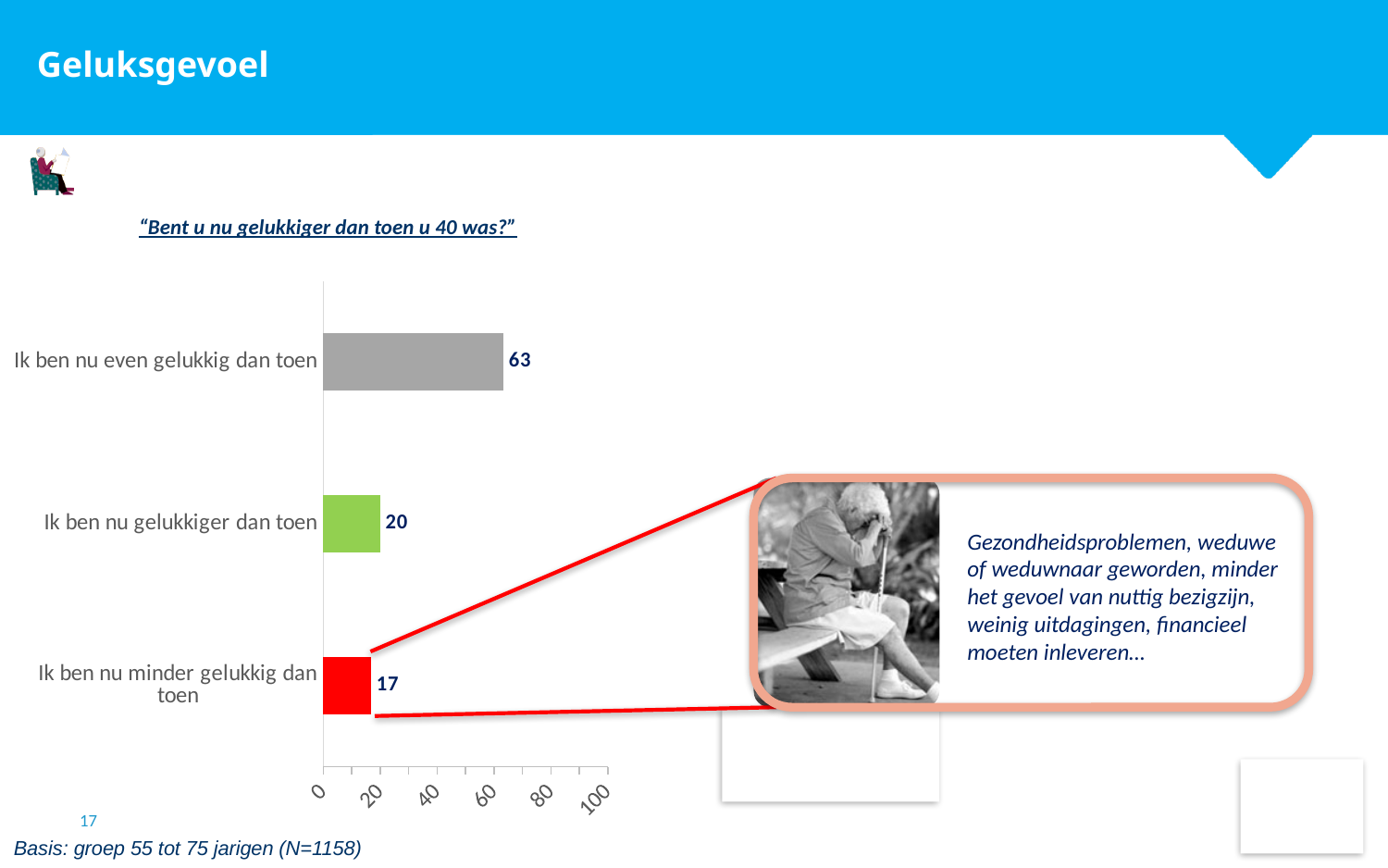
What kind of chart is shown on the slide? bar chart What is the difference between the values for "Ik ben nu gelukkiger dan toen" and "Ik ben nu minder gelukkig dan toen"? 3 How many categories are shown in the chart? 3 What is the value for "Ik ben nu gelukkiger dan toen"? 20 What is the value for "Ik ben nu even gelukkig dan toen"? 63 Which category has the highest value? Ik ben nu even gelukkig dan toen What is the difference between the values for "Ik ben nu even gelukkig dan toen" and "Ik ben nu gelukkiger dan toen"? 43 Which category has the lowest value? Ik ben nu minder gelukkig dan toen What colour is the bar for "Ik ben nu minder gelukkig dan toen"? red What is the value for "Ik ben nu minder gelukkig dan toen"? 17 Is the value for "Ik ben nu even gelukkig dan toen" greater or less than 60? greater Which is larger: the value for "Ik ben nu gelukkiger dan toen" or "Ik ben nu minder gelukkig dan toen"? Ik ben nu gelukkiger dan toen